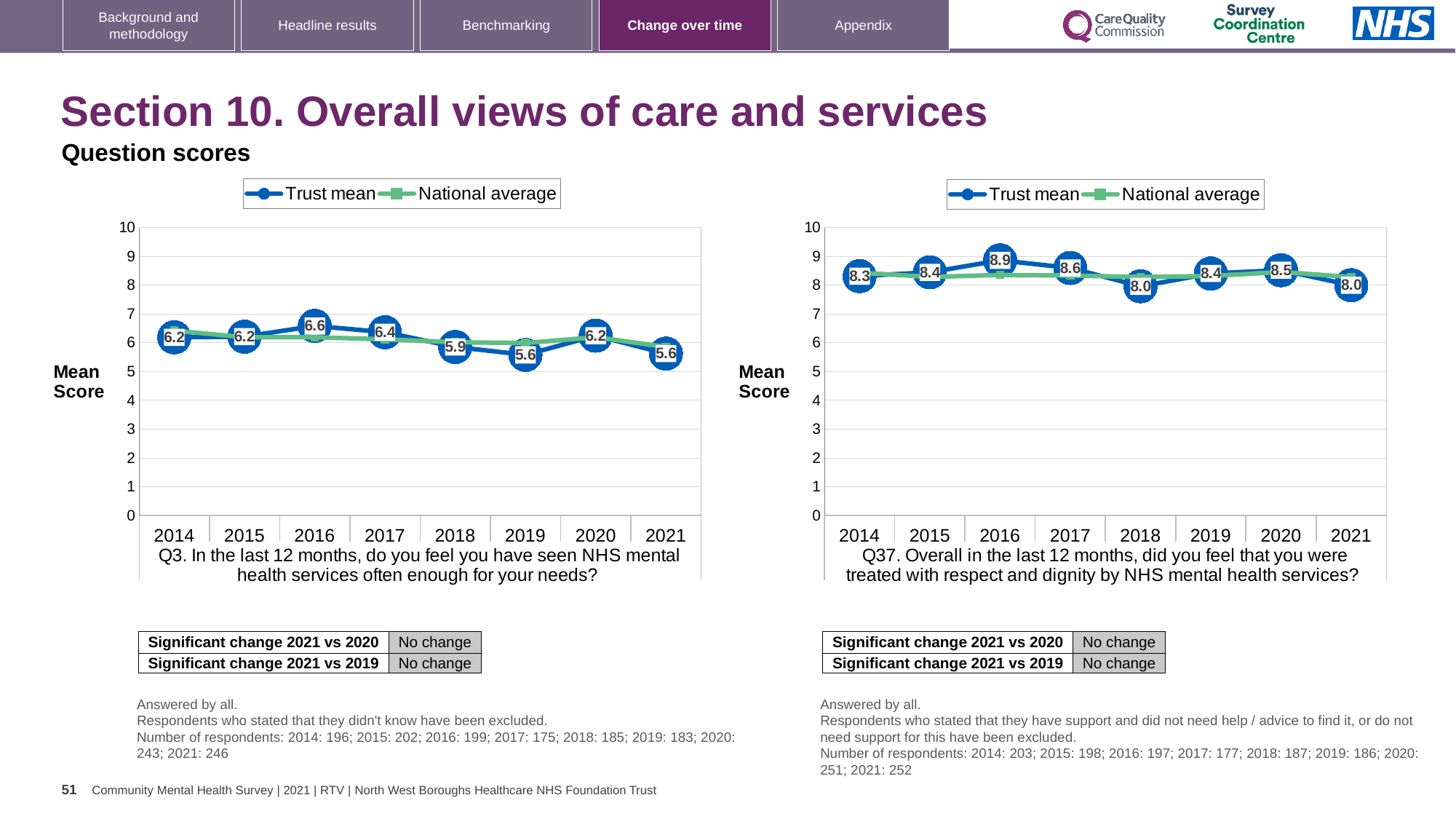
In the Q37 chart on the right, what is the Trust mean for 2018? 8.0 In the Q3 chart on the left, what is the difference between the Trust mean in 2016 and in 2019? 1.0 In the Q37 chart on the right, is the Trust mean for 2020 larger or smaller than the Trust mean for 2021? larger In the Q3 chart on the left, how many years are shown on the x axis? 8 In the Q37 chart on the right, what is the Trust mean for 2016? 8.9 What type of chart is the Q37 chart on the right? Line chart In the Q3 chart on the left, what is the Trust mean for 2016? 6.6 In the Q3 chart on the left, which year has the highest Trust mean? 2016 How many series does the legend of the Q3 chart on the left list? 2 In the Q37 chart on the right, which year has the highest Trust mean? 2016 In the Q3 chart on the left, what is the Trust mean for 2021? 5.6 In the Q37 chart on the right, what is the difference between the Trust mean in 2016 and in 2021? 0.9